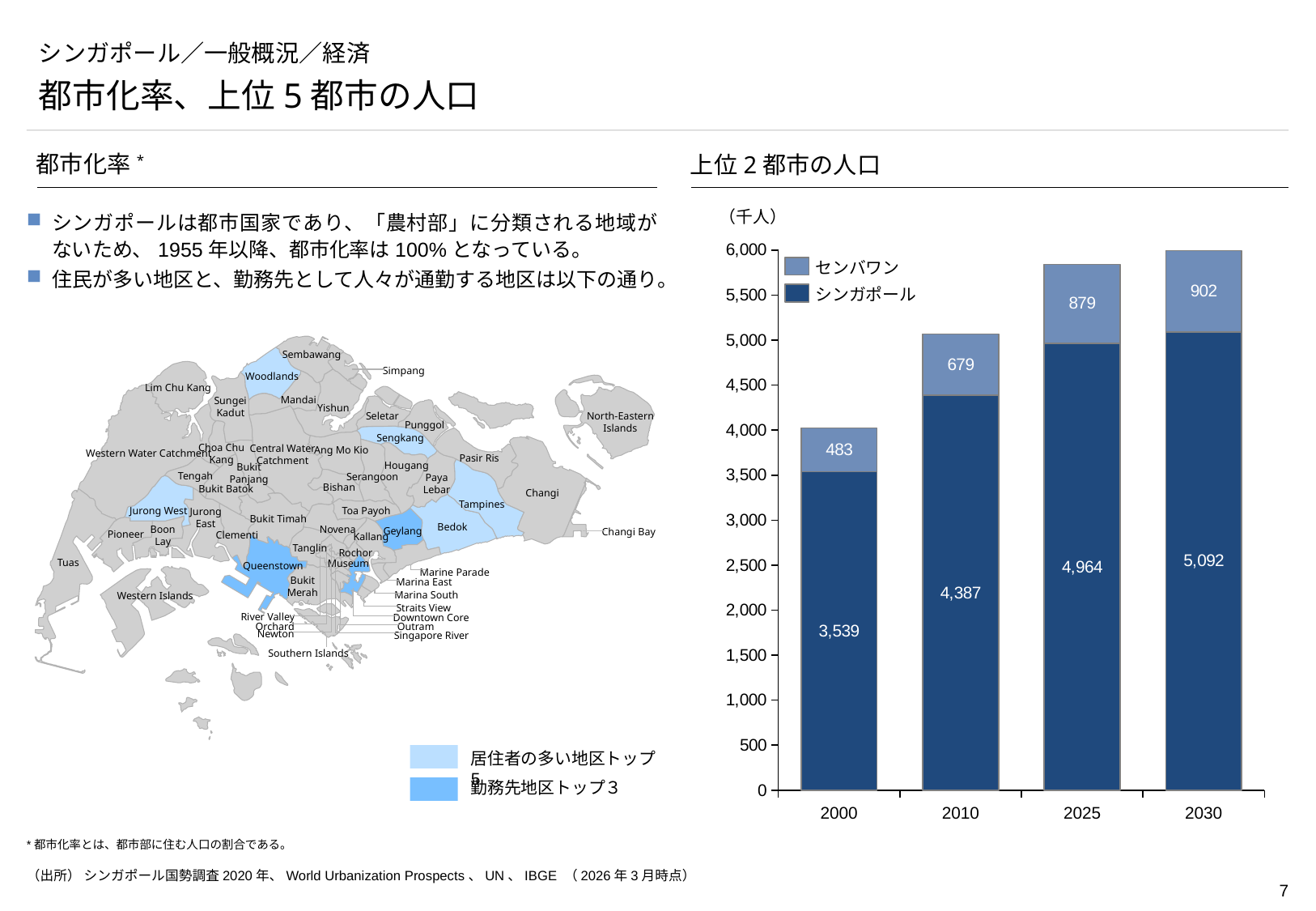
How many series does the chart legend list? 2 What is the total of the stacked bar for 2030? 5,994 What is the value for センバワン in 2025? 879 What is the value for シンガポール in 2010? 4,387 What is the value for シンガポール in 2000? 3,539 What is the total of the stacked bar for 2000? 4,022 How many years are shown on the x axis of the chart? 4 In which year is the value for シンガポール lowest? 2000 Which is larger, the センバワン value for 2010 or for 2000? 2010 What is the difference between the シンガポール values for 2030 and 2025? 128 In which year is the value for センバワン highest? 2030 Do the シンガポール values rise or fall from 2000 to 2030? rise